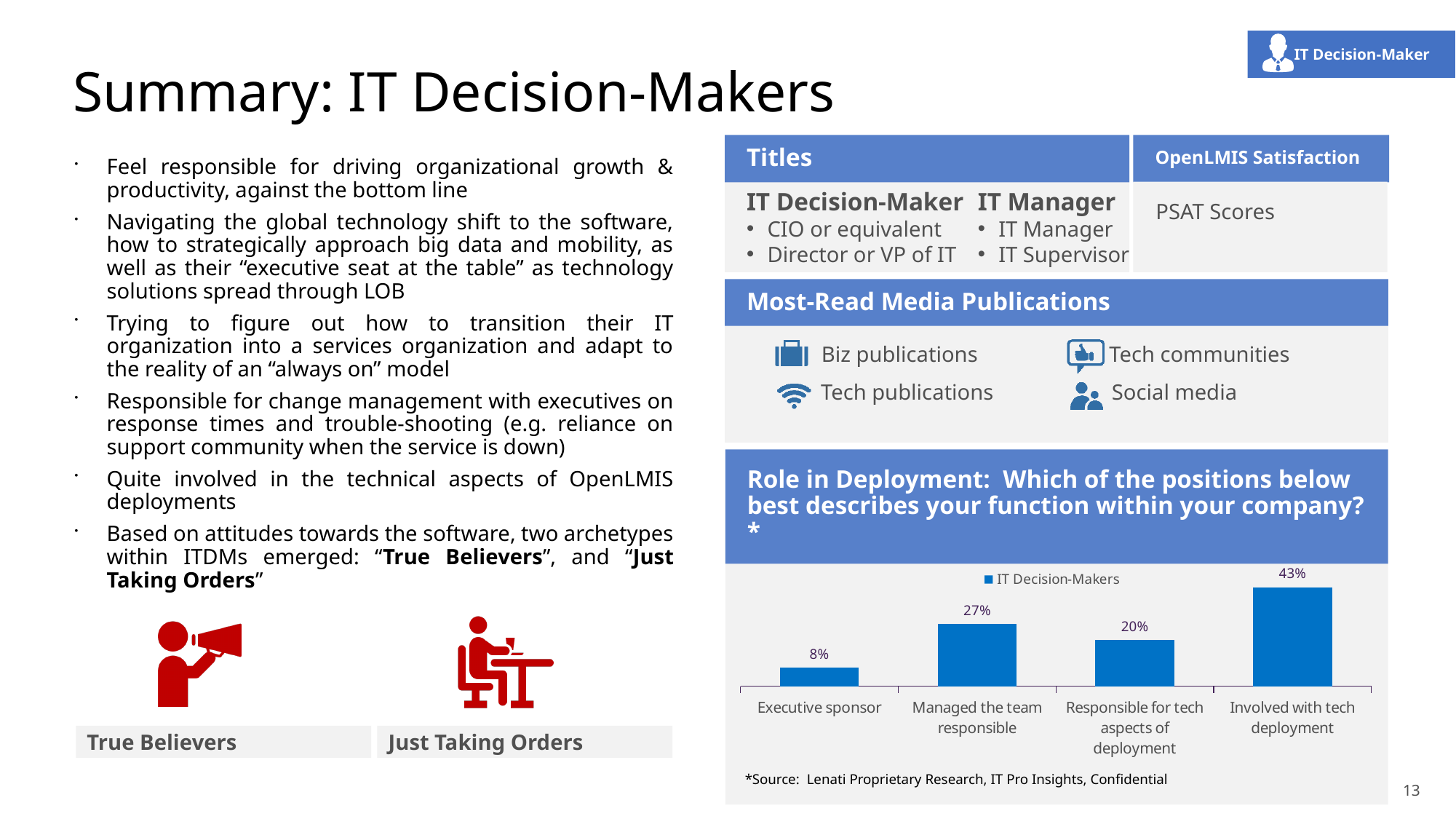
Which is larger: 'Managed the team responsible' or 'Responsible for tech aspects of deployment'? Managed the team responsible What is the value for 'Responsible for tech aspects of deployment'? 20% What is the value for 'Managed the team responsible'? 27% Which role has the lowest percentage in the Role in Deployment chart? Executive sponsor What is the value for 'Executive sponsor' in the Role in Deployment chart? 8% How many series does the legend of the Role in Deployment chart list? 1 Which role has the highest percentage in the Role in Deployment chart? Involved with tech deployment What percentage of IT Decision-Makers are 'Involved with tech deployment'? 43% How many categories are shown in the Role in Deployment chart? 4 What is the difference between 'Managed the team responsible' and 'Responsible for tech aspects of deployment'? 7% What is the difference between 'Involved with tech deployment' and 'Executive sponsor'? 35% What type of chart is used for the Role in Deployment data? Bar chart